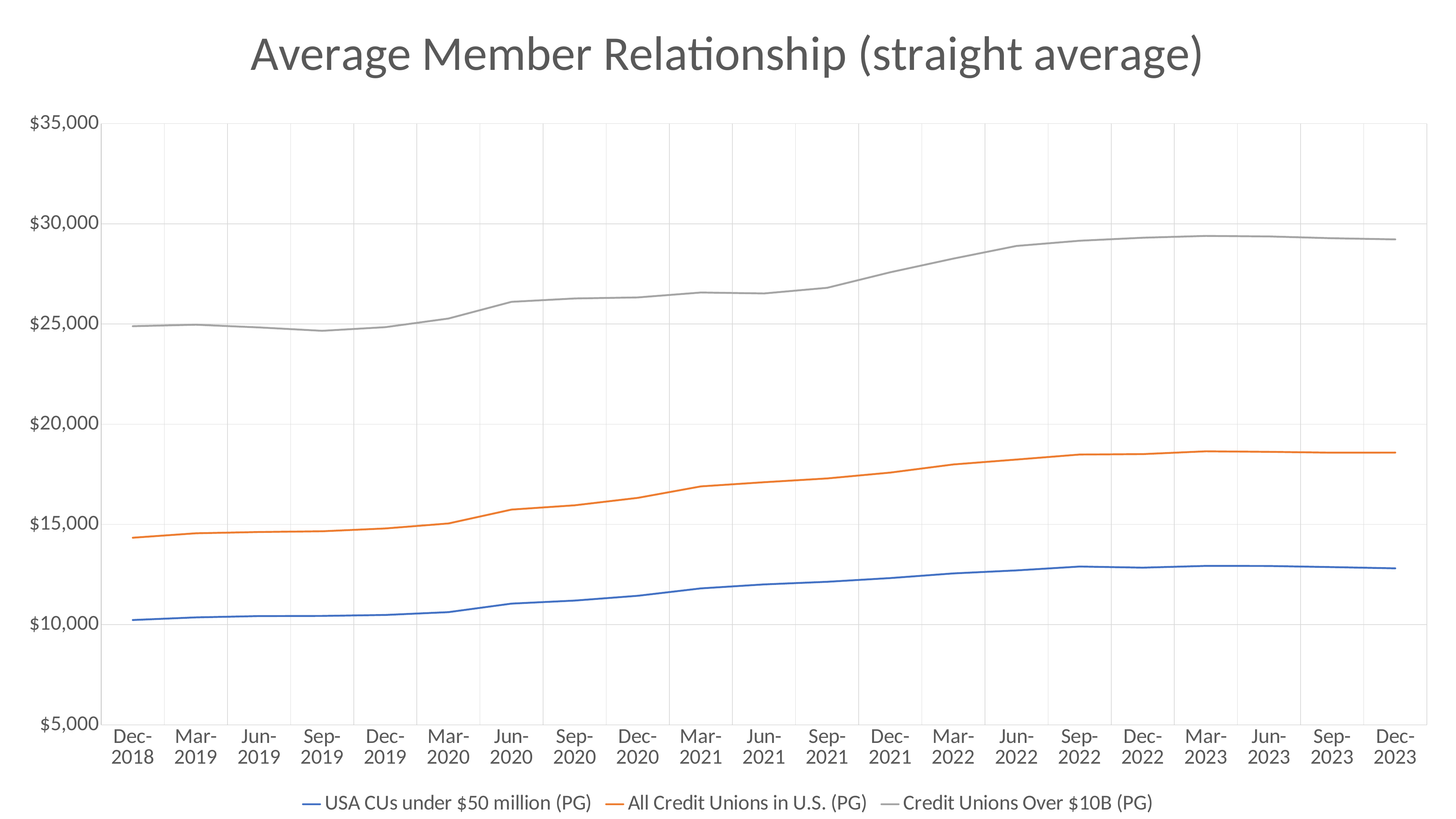
Which series has the lowest values throughout the chart? USA CUs under $50 million (PG) At Dec-2023, which is larger: the value for All Credit Unions in U.S. (PG) or the value for USA CUs under $50 million (PG)? All Credit Unions in U.S. (PG) What kind of chart is shown on the slide? line chart How many series does the legend list? 3 Which series has the highest values throughout the chart? Credit Unions Over $10B (PG) Do the values for All Credit Unions in U.S. (PG) generally rise or fall from Dec-2018 to Dec-2023? rise Is the value for Credit Unions Over $10B (PG) at Dec-2023 greater or less than $25,000? greater Is the value for USA CUs under $50 million (PG) at Dec-2023 greater or less than $15,000? less What colour is the line for Credit Unions Over $10B (PG)? gray What is the title of the chart? Average Member Relationship (straight average) How many time points are shown along the x axis? 21 Is the value for All Credit Unions in U.S. (PG) at Dec-2023 greater or less than $20,000? less